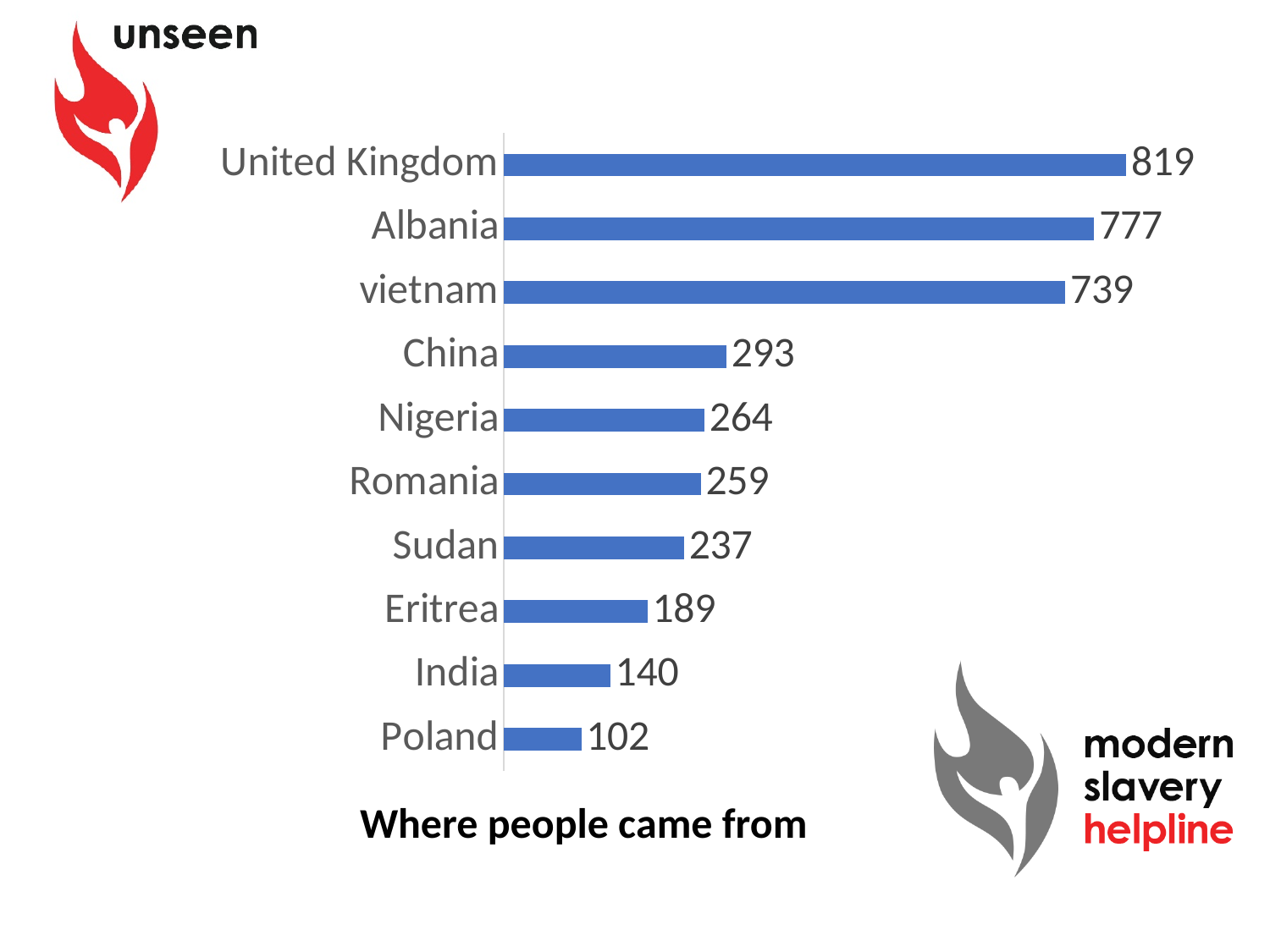
What is the title of the chart? Where people came from What is the value for Albania? 777 What is the difference between the values for China and India? 153 What is the value for Poland? 102 What kind of chart is shown on the slide? Bar chart Which is larger, the value for Nigeria or the value for Eritrea? Nigeria Which country has the lowest value? Poland Which country has the highest value? United Kingdom What is the difference between the values for the United Kingdom and Albania? 42 How many countries are shown in the chart? 10 What is the value for the United Kingdom? 819 What is the value for Sudan? 237